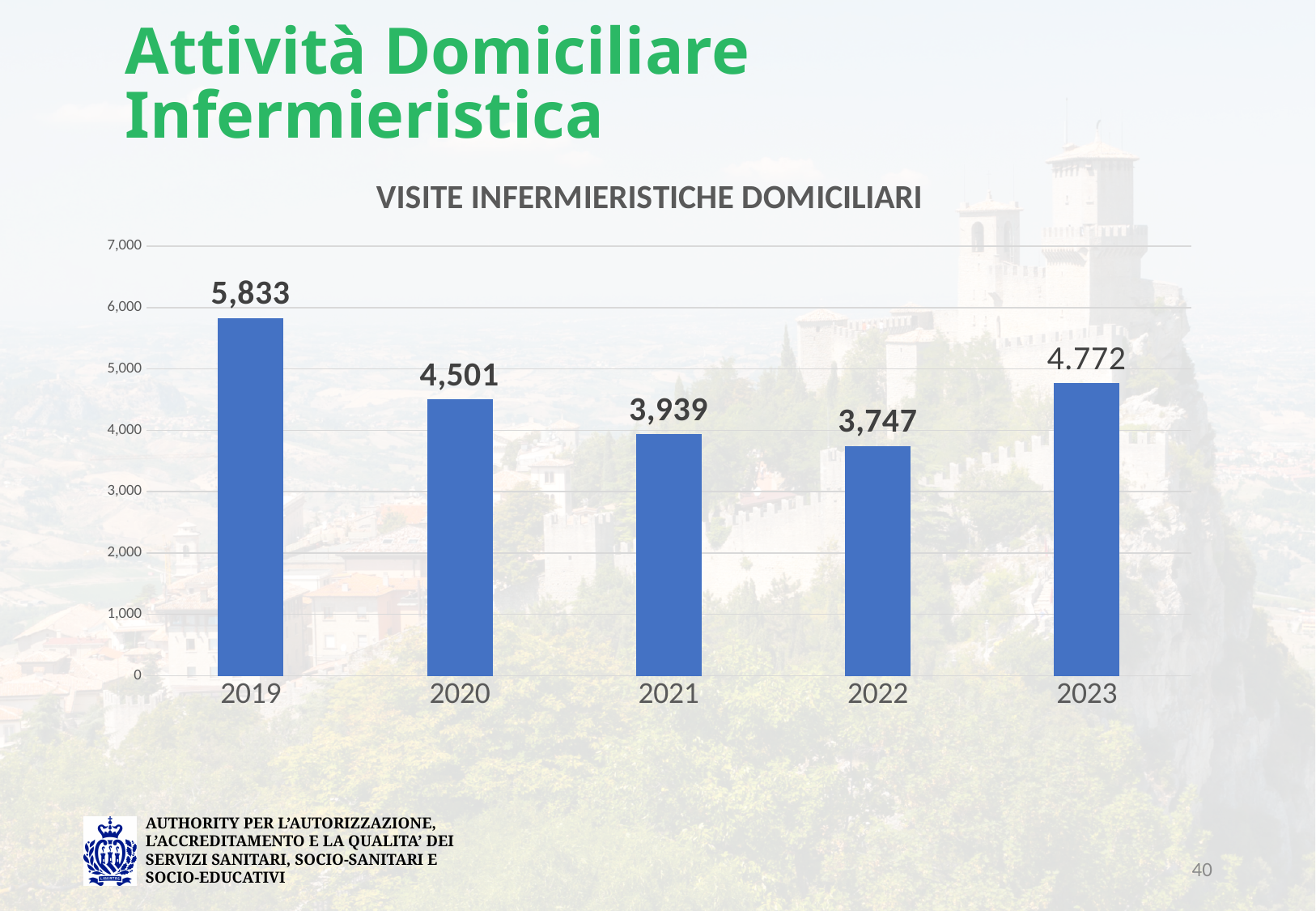
How many years are shown on the x axis? 5 What is the value for 2023? 4.772 What is the difference between the values for 2019 and 2020? 1,332 What kind of chart is this? bar chart What is the value for 2022? 3,747 What is the title of the chart? VISITE INFERMIERISTICHE DOMICILIARI Is the value for 2021 greater or less than 4,000? less Which is larger, the value for 2020 or the value for 2023? 2023 Which year has the lowest number of visits? 2022 What is the difference between the values for 2021 and 2022? 192 What is the value for 2019? 5,833 Which year has the highest number of visits? 2019